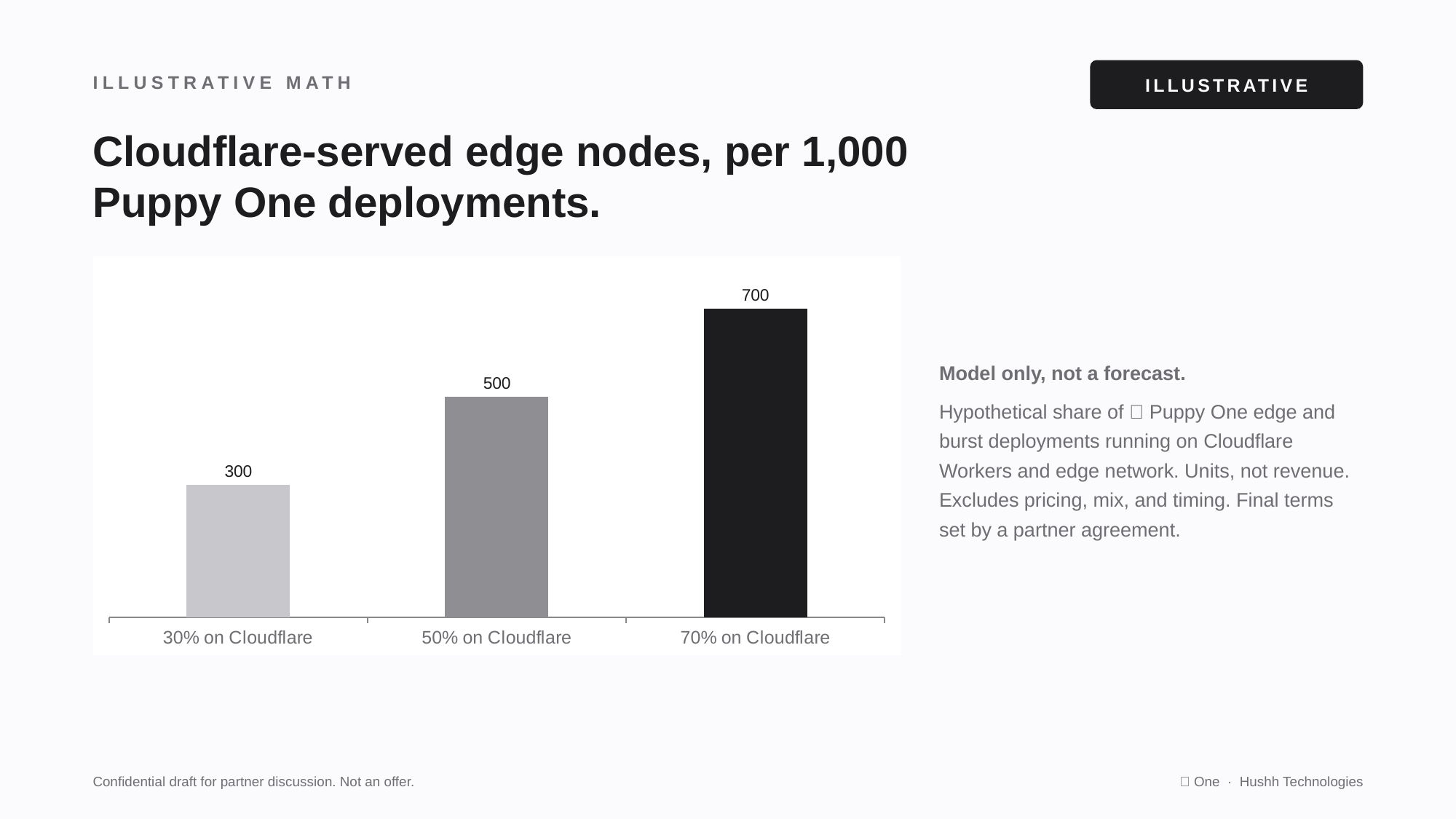
What kind of chart is shown on the slide? Bar chart Which category has the highest value? 70% on Cloudflare What is the difference between the values for 70% on Cloudflare and 30% on Cloudflare? 400 How many categories are shown in the chart? 3 Do the values rise or fall from left to right across the categories? Rise Which category has the lowest value? 30% on Cloudflare What is the value for 70% on Cloudflare? 700 What is the difference between the values for 50% on Cloudflare and 30% on Cloudflare? 200 What is the value for 30% on Cloudflare? 300 What is the value for 50% on Cloudflare? 500 What is the title of the chart on the slide? Cloudflare-served edge nodes, per 1,000 Puppy One deployments. Which is larger, the value for 50% on Cloudflare or the value for 70% on Cloudflare? 70% on Cloudflare